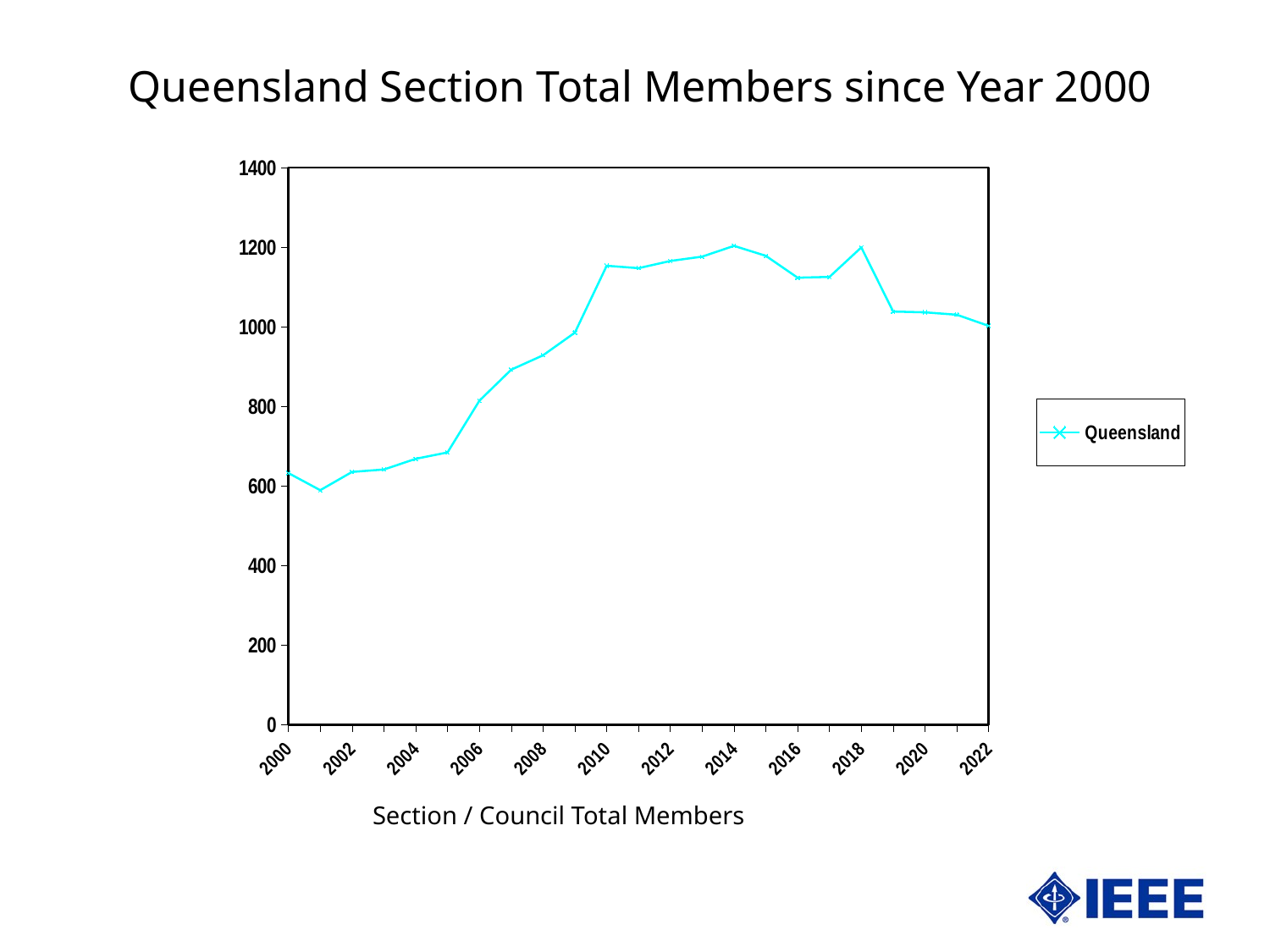
Is the value for 2016 greater or less than 1000? greater What is the title of the chart? Queensland Section Total Members since Year 2000 How many series does the legend list? 1 Which year has the larger number of members, 2005 or 2010? 2010 Is the value for 2001 greater or less than 600? less In which year is the number of Queensland members lowest? 2001 What kind of chart is shown on the slide? line chart Is the value for 2010 greater or less than 1000? greater What is the name of the series shown in the legend? Queensland Do the values rise or fall between 2018 and 2022? fall